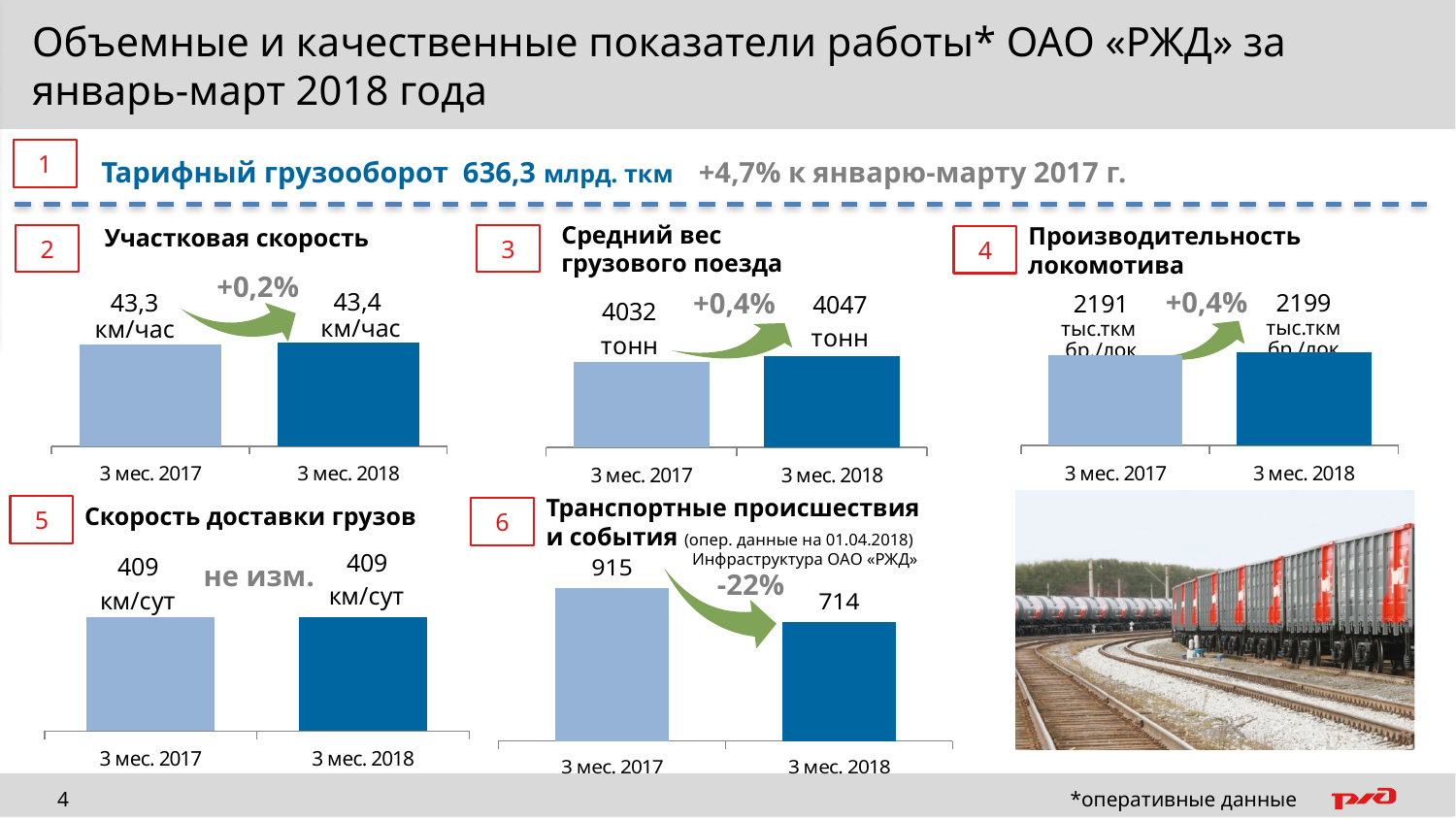
In the 'Производительность локомотива' chart, what is the value for 3 мес. 2018? 2199 тыс.ткм бр./лок In the 'Транспортные происшествия и события' chart, which period has the lowest value? 3 мес. 2018 In the 'Транспортные происшествия и события' chart, do the values rise or fall from 3 мес. 2017 to 3 мес. 2018? fall In the 'Средний вес грузового поезда' chart, what is the value for 3 мес. 2017? 4032 тонн In the 'Транспортные происшествия и события' chart, what is the value for 3 мес. 2018? 714 What kind of chart is the 'Участковая скорость' chart? bar chart In the 'Участковая скорость' chart, what is the value for 3 мес. 2018? 43,4 км/час In the 'Средний вес грузового поезда' chart, what is the difference between 3 мес. 2018 and 3 мес. 2017? 15 тонн In the 'Транспортные происшествия и события' chart, what is the difference between 3 мес. 2017 and 3 мес. 2018? 201 In the 'Производительность локомотива' chart, which period has the higher value, 3 мес. 2017 or 3 мес. 2018? 3 мес. 2018 In the 'Скорость доставки грузов' chart, what is the percentage change shown between the two periods? не изм. In the 'Скорость доставки грузов' chart, what is the value for 3 мес. 2017? 409 км/сут